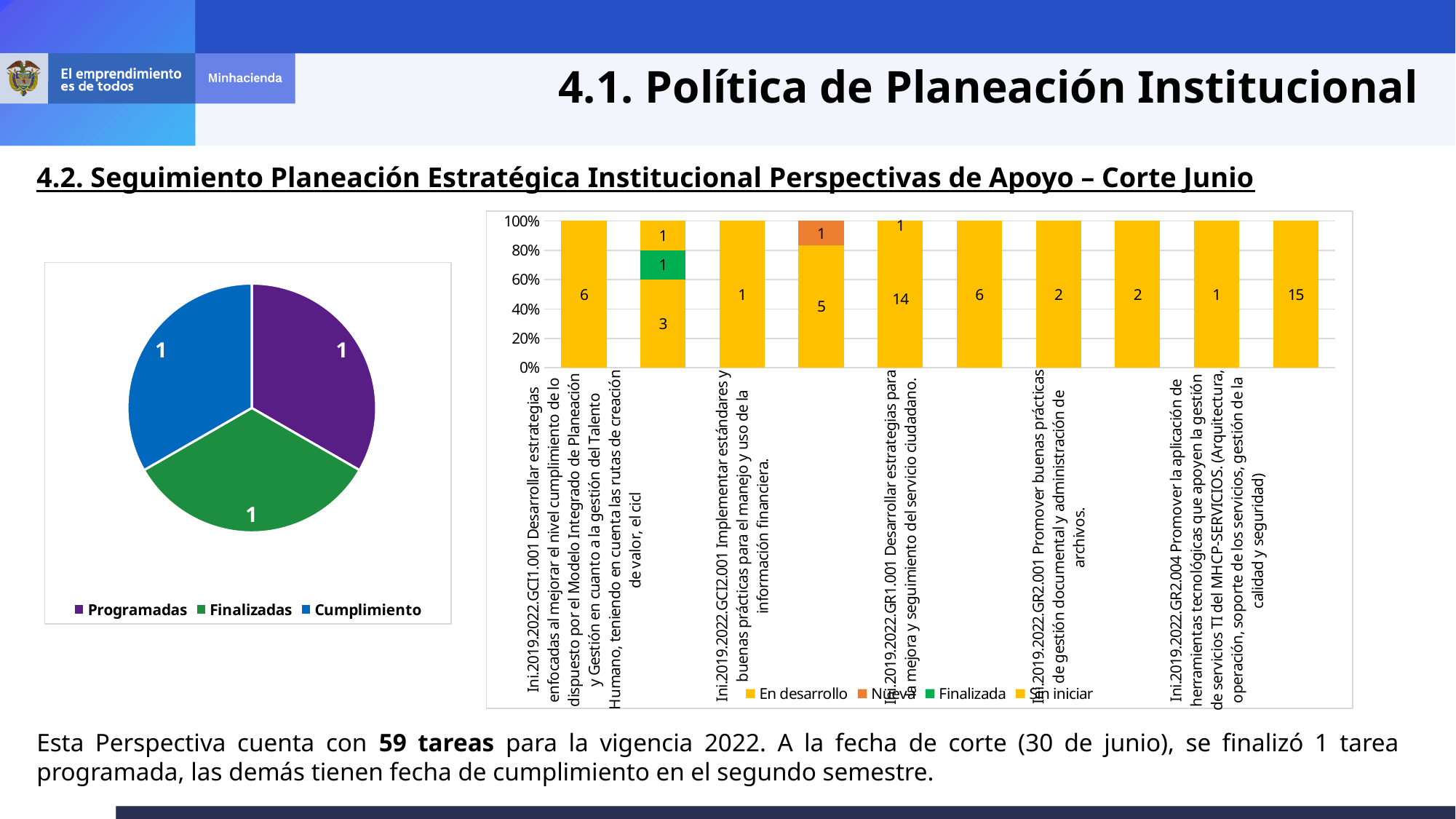
In the bar chart on the right, what is the total of the segments in the bar for Ini.2019.2022.GR1.001 (14 and 1)? 15 How many slices does the pie chart on the left have? 3 How many bars are plotted in the bar chart on the right? 10 In the bar chart on the right, what is the total of the segments in the second bar from the left (3, 1 and 1)? 5 What kind of chart is the chart on the right of the slide? bar chart How many series does the legend of the bar chart on the right list? 4 How many entries does the legend of the pie chart on the left list? 3 In the bar chart on the right, which series does the orange segment in the fourth bar belong to? Nueva In the pie chart on the left, what is the value shown for Finalizadas? 1 What kind of chart is the chart on the left of the slide? pie chart In the pie chart on the left, which legend entry is shown in blue? Cumplimiento In the bar chart on the right, what value is printed on the bar for Ini.2019.2022.GCI1.001? 6